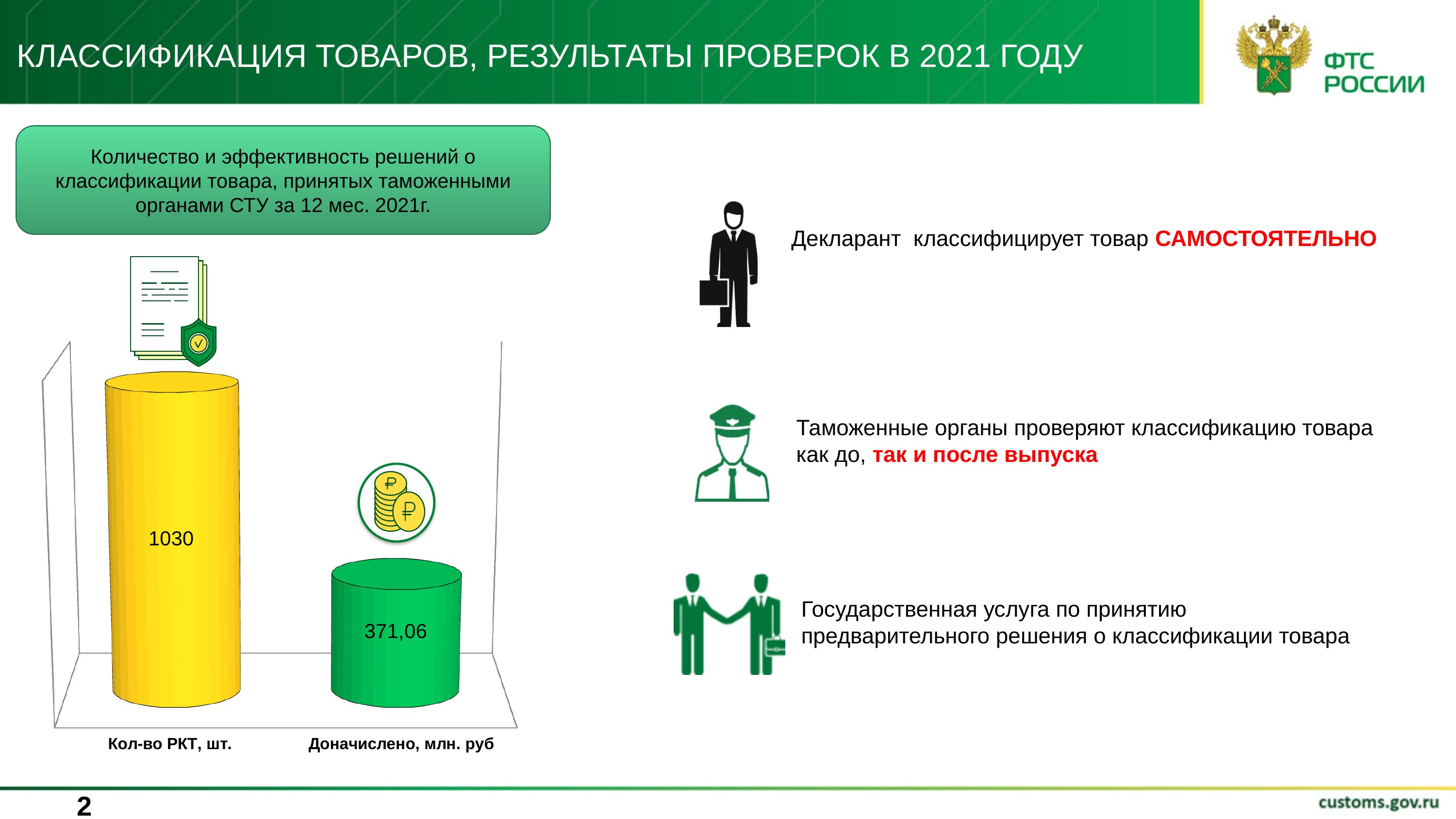
What is the value shown for "Кол-во РКТ, шт."? 1030 What is the value shown for "Доначислено, млн. руб"? 371,06 What colour is the bar for "Доначислено, млн. руб"? Green Which category has the lowest bar? Доначислено, млн. руб Which bar is taller: "Кол-во РКТ, шт." or "Доначислено, млн. руб"? Кол-во РКТ, шт. Which category has the highest bar? Кол-во РКТ, шт. Do the bar values rise or fall from left to right? Fall What colour is the bar for "Кол-во РКТ, шт."? Yellow How many categories are plotted in the chart? 2 What kind of chart is shown on the slide? Bar chart